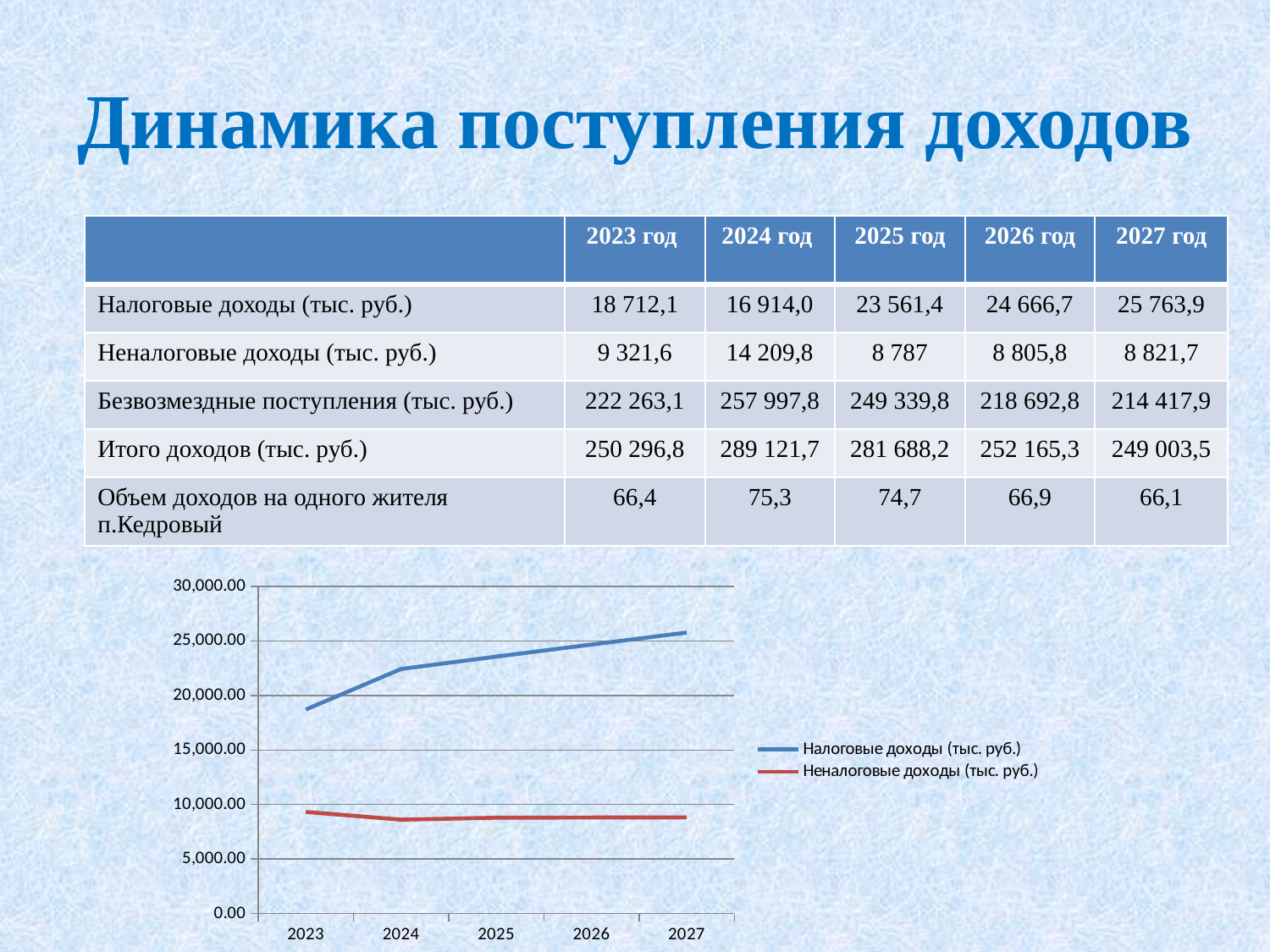
Does the line for Налоговые доходы (тыс. руб.) rise or fall from 2023 to 2027? rise Is the value for Неналоговые доходы (тыс. руб.) in 2027 greater or less than 5,000.00? greater Is the value for Налоговые доходы (тыс. руб.) in 2027 greater or less than 25,000.00? greater What colour is the line for Неналоговые доходы (тыс. руб.) in the chart? red Is the value for Налоговые доходы (тыс. руб.) in 2023 greater or less than 20,000.00? less In which year is the line for Налоговые доходы (тыс. руб.) at its highest? 2027 In 2025, which series has the larger value: Налоговые доходы (тыс. руб.) or Неналоговые доходы (тыс. руб.)? Налоговые доходы (тыс. руб.) What kind of chart is shown on the slide? line chart How many years are shown on the x axis of the chart? 5 How many series does the chart legend list? 2 In which year is the line for Налоговые доходы (тыс. руб.) at its lowest? 2023